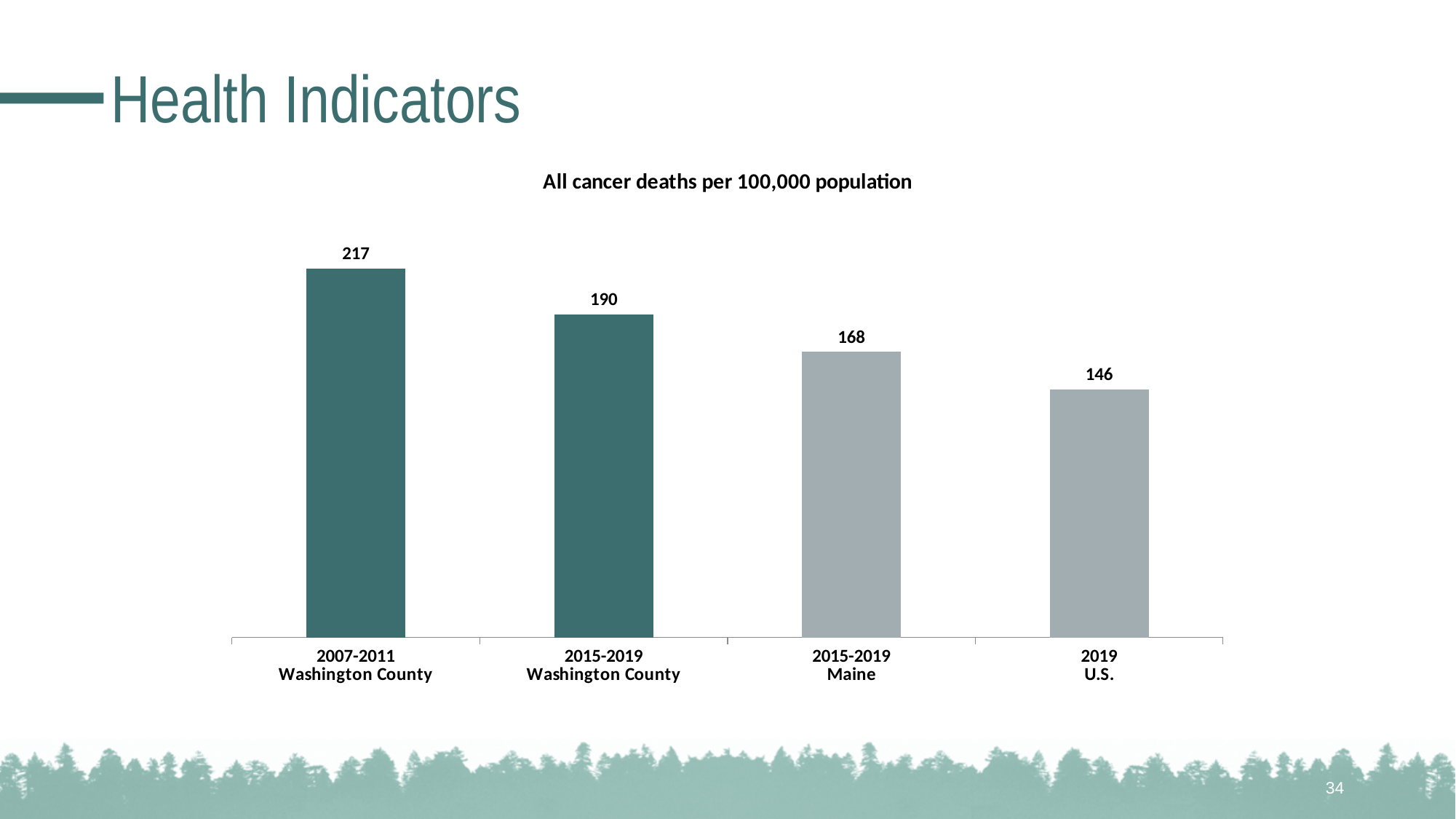
How many bars are shown in the chart? 4 What is the title of the chart? All cancer deaths per 100,000 population What is the value for 2015-2019 Washington County? 190 What is the difference between the 2015-2019 Washington County value and the 2015-2019 Maine value? 22 What is the difference between the 2007-2011 and 2015-2019 Washington County values? 27 What is the value for 2007-2011 Washington County? 217 Which category has the lowest value? 2019 U.S. What kind of chart is shown on the slide? Bar chart Which is larger, the value for 2015-2019 Maine or the value for 2019 U.S.? 2015-2019 Maine What is the value for 2015-2019 Maine? 168 Which category has the highest value? 2007-2011 Washington County What is the value for 2019 U.S.? 146